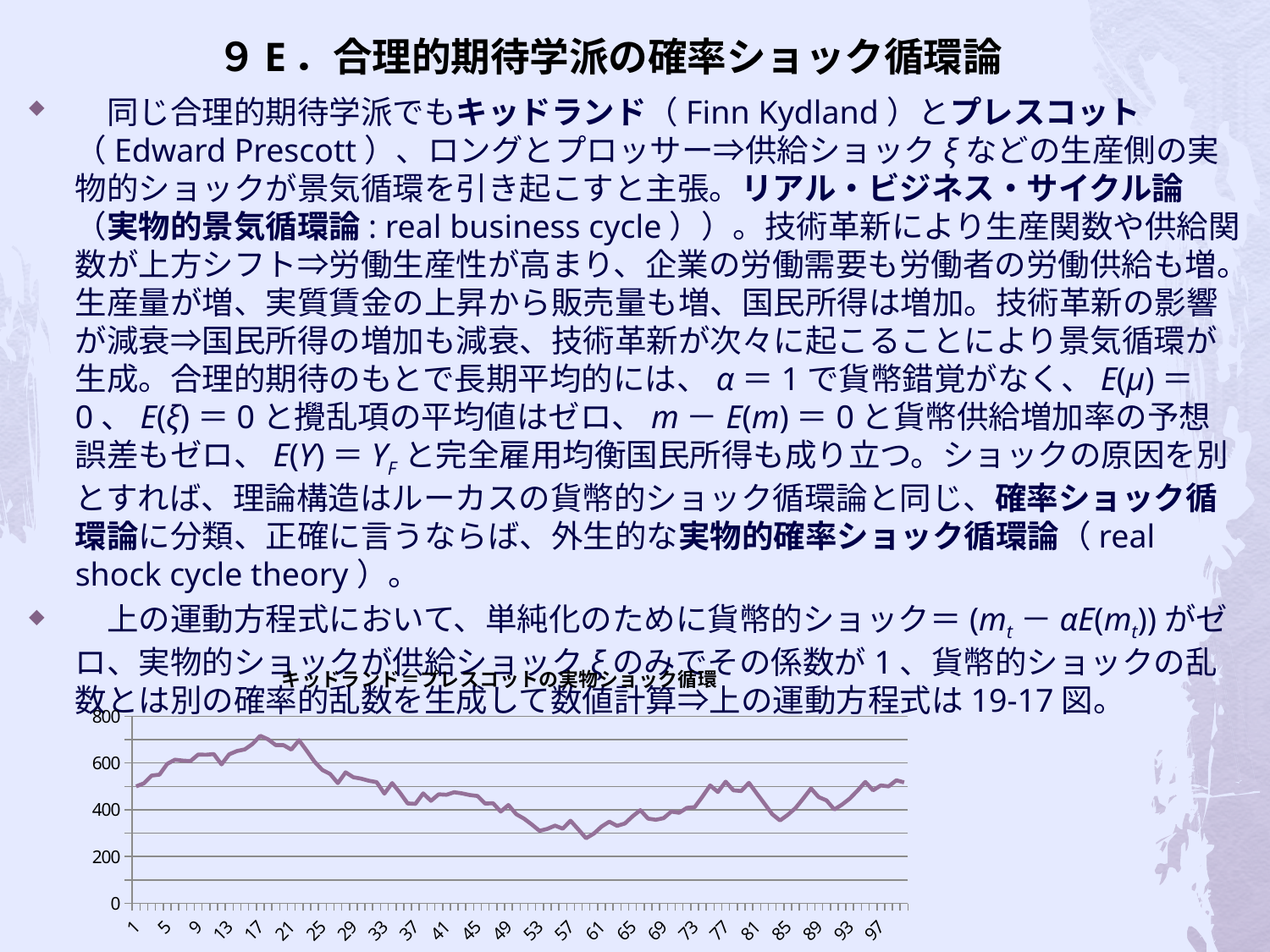
Which is larger, the value at x = 17 or the value at x = 61? x = 17 What is the title of the chart on the slide? キッドランド＝プレスコットの実物ショック循環 Do the values generally rise or fall between x = 21 and x = 61? fall Is the value at x = 17 greater or less than 600? greater What kind of chart is shown at the bottom of the slide? line chart Is the value at x = 53 greater or less than 400? less Is the value at x = 1 greater or less than 400? greater Do the values generally rise or fall between x = 61 and x = 77? rise What is the highest value shown on the vertical axis of the chart? 800